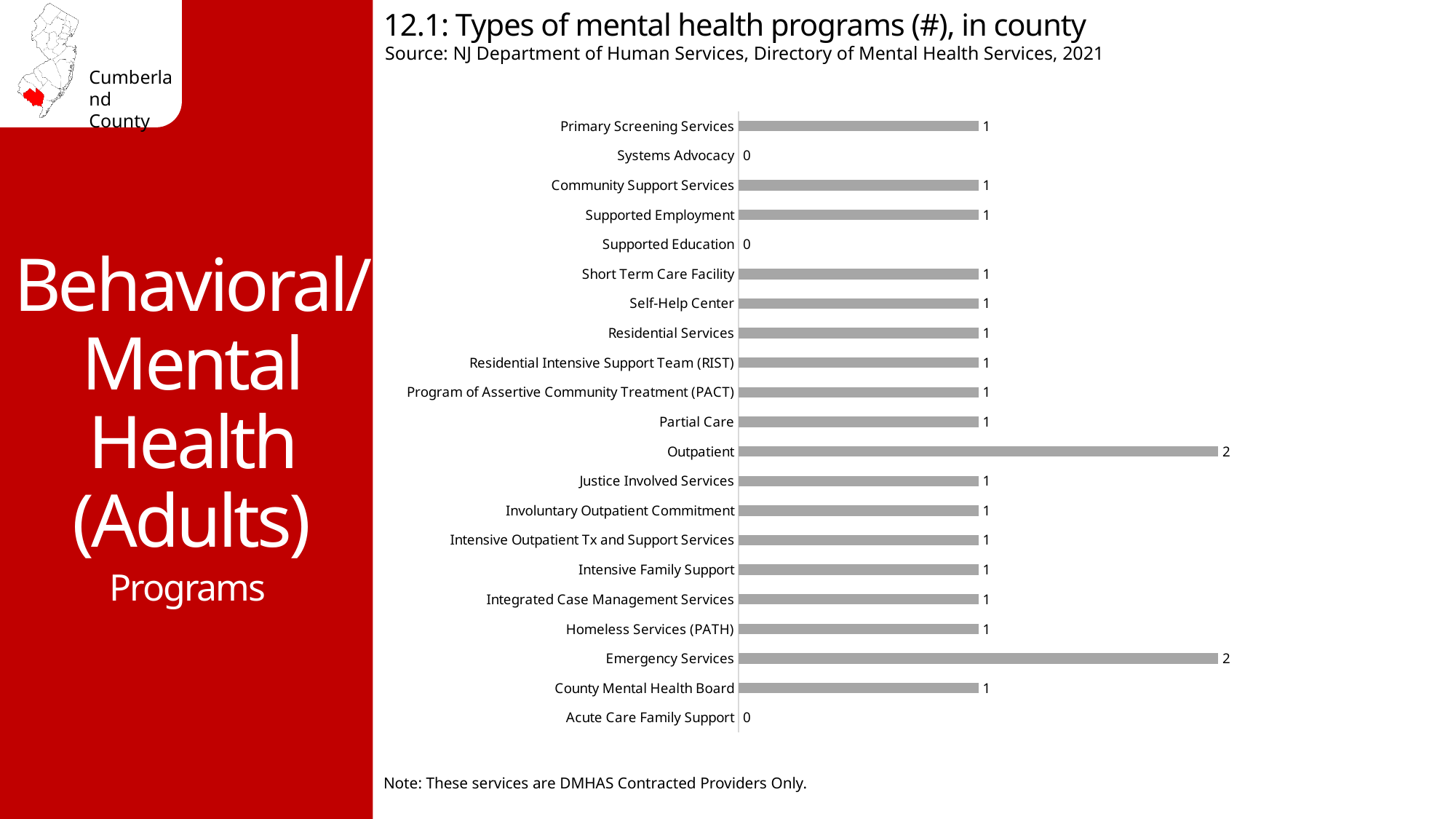
What is the value for Partial Care? 1 What is the title of the chart? 12.1: Types of mental health programs (#), in county What kind of chart is shown on the slide? Bar chart What is the value for Outpatient? 2 What is the difference between the value for Emergency Services and the value for Homeless Services (PATH)? 1 What is the value for Emergency Services? 2 What is the value for Systems Advocacy? 0 Which is larger, the value for Outpatient or the value for Partial Care? Outpatient How many categories are shown on the chart? 21 What is the value for Acute Care Family Support? 0 How many categories have a value of 0? 3 How many categories have a value of 2? 2